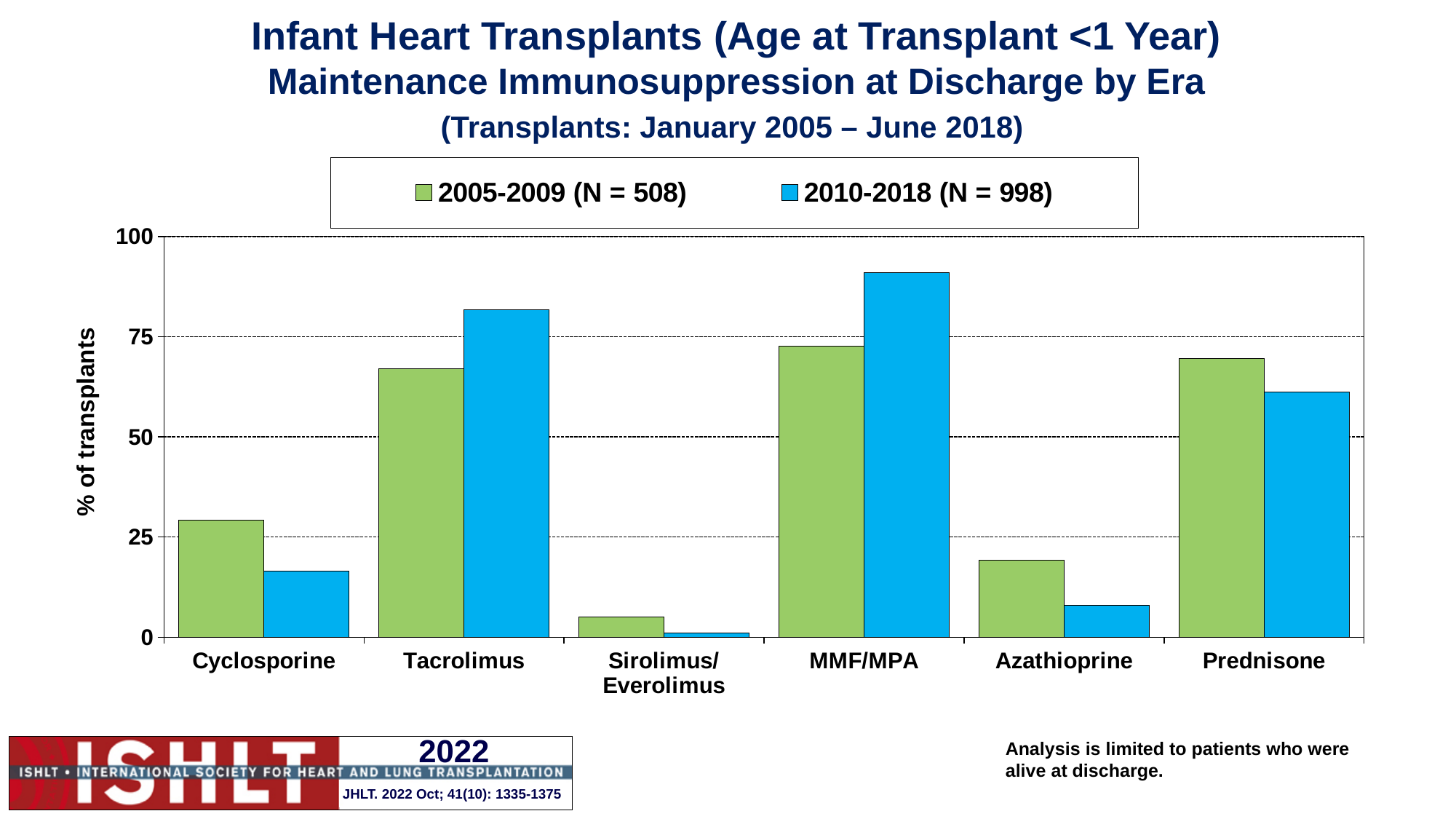
For Tacrolimus, which era has the larger value, 2005-2009 or 2010-2018? 2010-2018 Is the value for Tacrolimus in 2010-2018 greater or less than 75? greater How many series does the legend list? 2 Which drug has the lowest value for the 2010-2018 (N = 998) series? Sirolimus/Everolimus Which drug has the lowest value for the 2005-2009 (N = 508) series? Sirolimus/Everolimus Which drug has the highest value for the 2010-2018 (N = 998) series? MMF/MPA Is the value for Cyclosporine in 2010-2018 greater or less than 25? less What kind of chart is shown on the slide? bar chart What is the label of the y axis? % of transplants How many drug categories are shown on the x axis? 6 Is the value for Prednisone in 2010-2018 greater or less than 50? greater For Prednisone, which era has the larger value, 2005-2009 or 2010-2018? 2005-2009